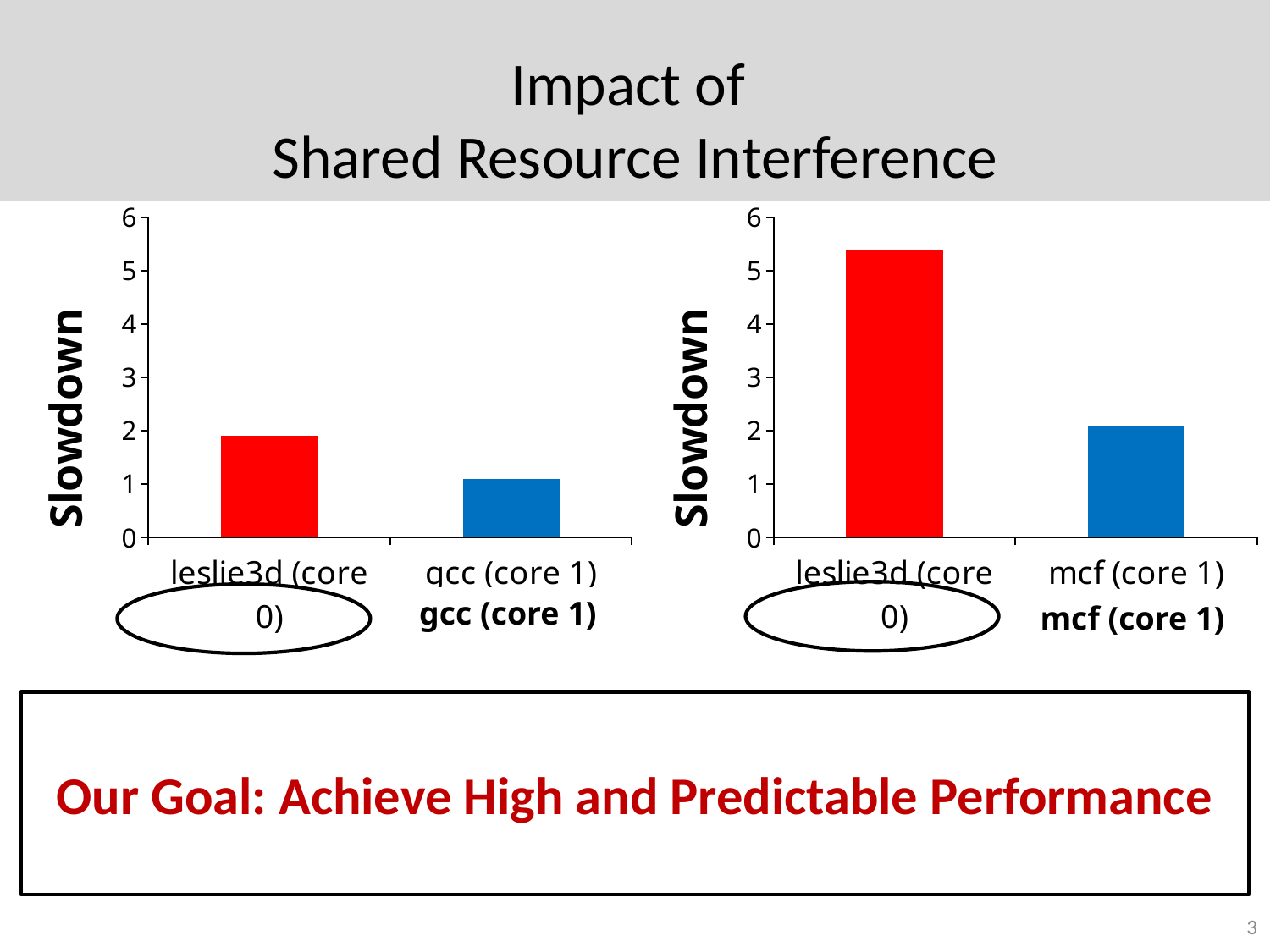
In the right chart, which category has the highest slowdown? leslie3d (core 0) In the left chart, is the slowdown for leslie3d (core 0) greater or less than 1? greater In the right chart, is the slowdown for mcf (core 1) greater or less than 3? less What type of chart is the left chart on the slide? bar chart In the right chart, which category has the lowest slowdown? mcf (core 1) What is the y-axis label of the right chart? Slowdown In the left chart, which category has the higher slowdown? leslie3d (core 0) In the left chart, how many bars are plotted? 2 In the left chart, which category has the lowest slowdown? gcc (core 1) In the right chart, is the slowdown for leslie3d (core 0) greater or less than 5? greater In the right chart, how many categories are shown on the x axis? 2